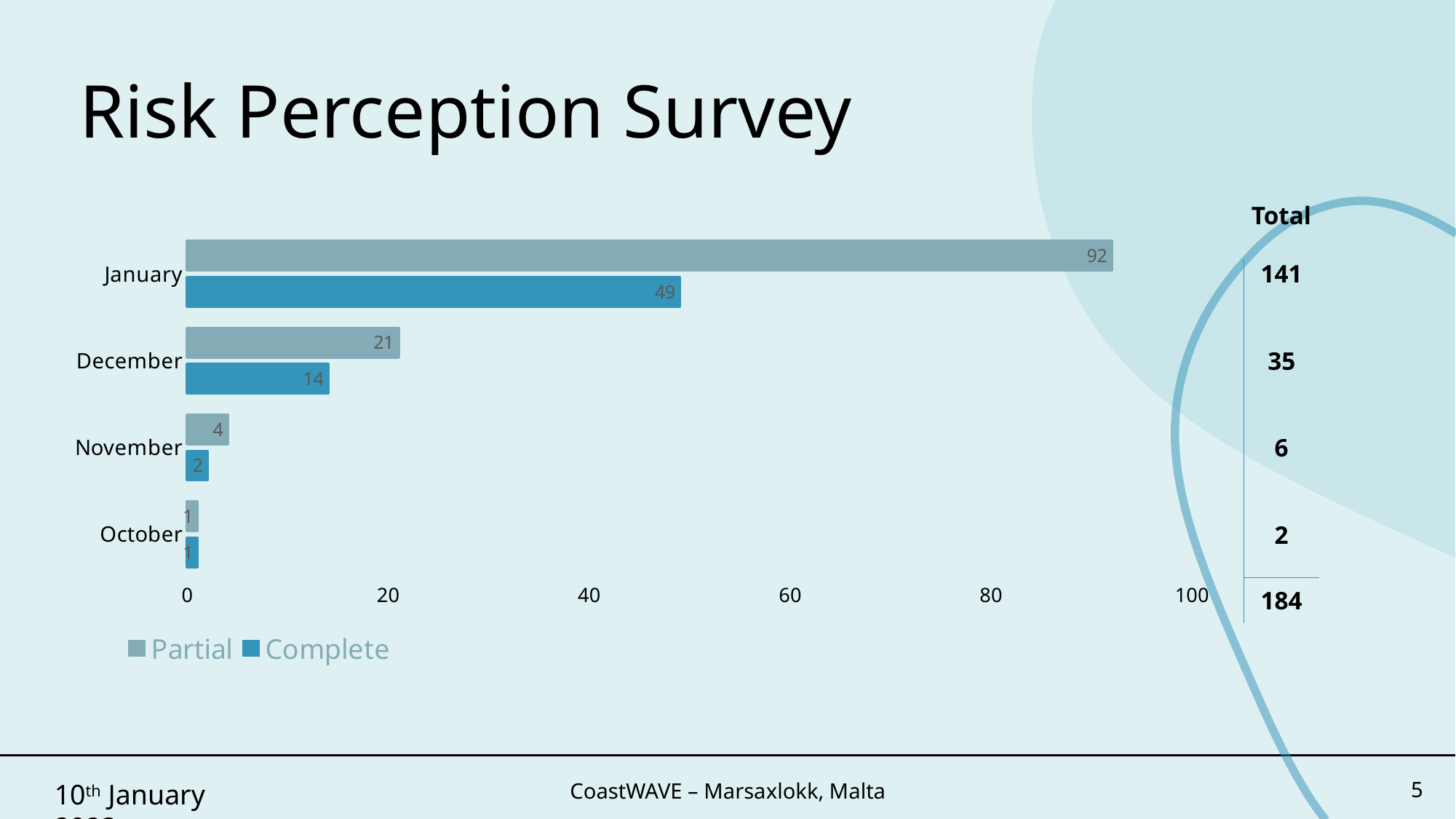
Which month has the lowest Complete value? October How many months are shown on the chart? 4 What is the difference between the Partial and Complete values for January? 43 How many series does the legend list? 2 Which is larger for December, the Partial value or the Complete value? Partial What is the total of Partial and Complete for December? 35 What kind of chart is shown on the slide? Bar chart What is the Partial value for January? 92 What is the Complete value for November? 2 What are the two series named in the legend? Partial and Complete Which month has the highest Partial value? January What is the Complete value for December? 14